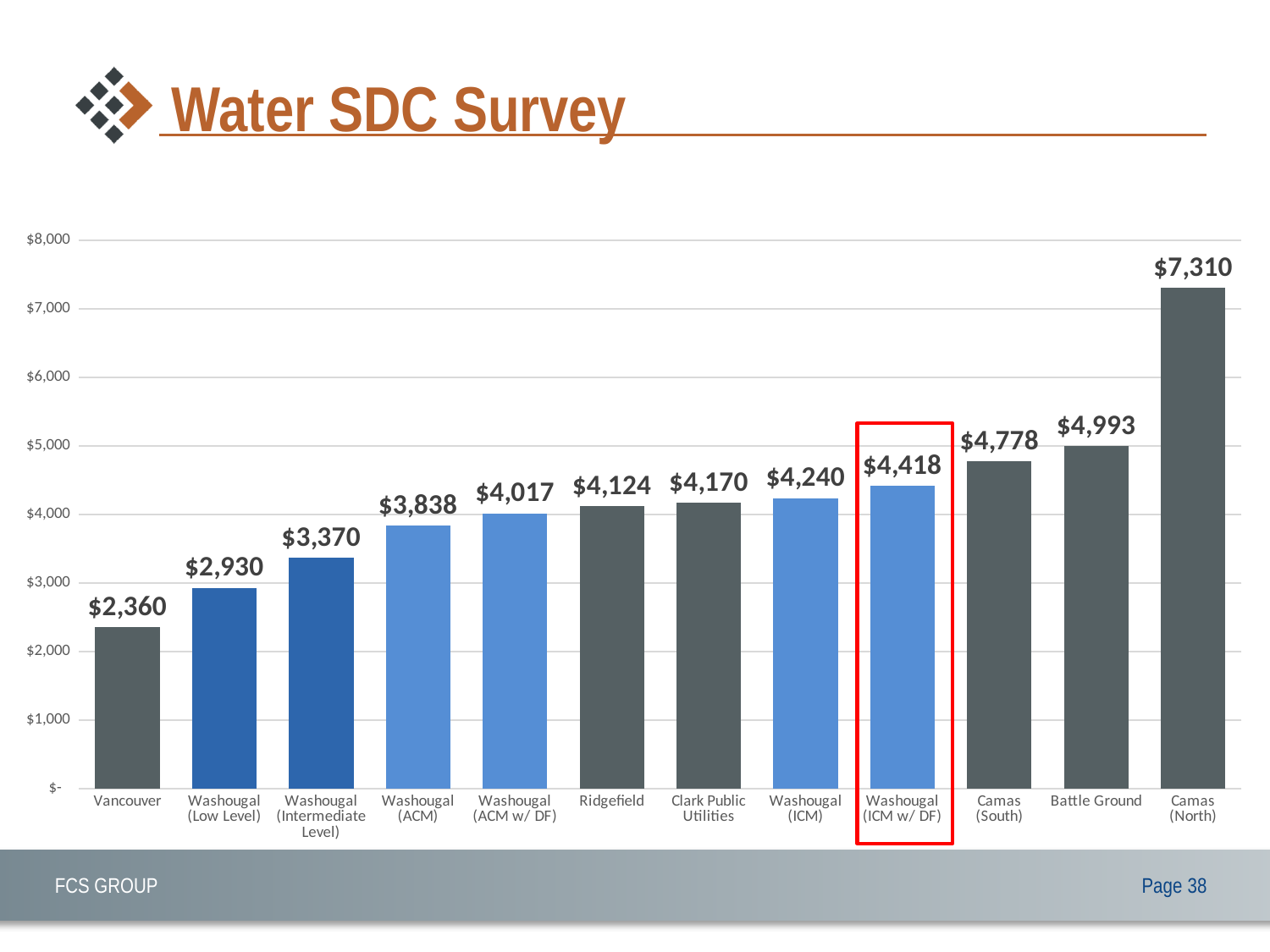
Which category has the lowest value? Vancouver Is the value for Clark Public Utilities greater or less than $4,000? greater What is the difference between Washougal (ICM w/ DF) and Washougal (ICM)? $178 What is the difference between Camas (North) and Camas (South)? $2,532 What is the value for Washougal (ICM w/ DF)? $4,418 What is the value for Battle Ground? $4,993 Which category is highlighted with a red box? Washougal (ICM w/ DF) Which category has the highest value? Camas (North) Which is larger, Ridgefield or Washougal (ACM)? Ridgefield What is the value for Vancouver? $2,360 How many categories are shown on the x axis? 12 What kind of chart is shown on the slide? bar chart